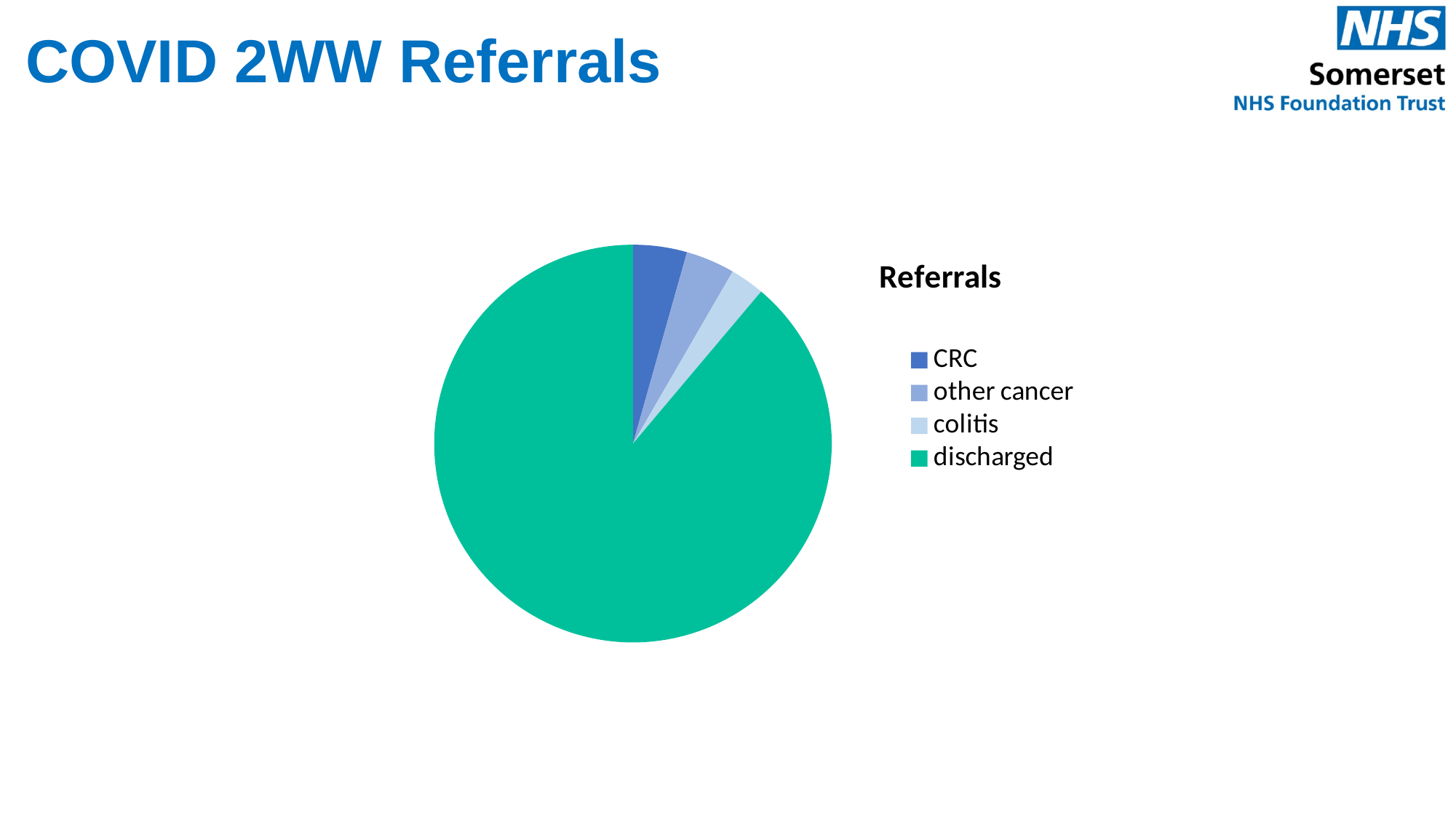
Which category is listed first in the legend? CRC Does the discharged slice account for more or less than half of the pie? more What is the title of the chart? Referrals Which legend entry is shown in green? discharged Which is larger, the slice for colitis or the slice for discharged? discharged What kind of chart is shown on the slide? pie chart Which is larger, the slice for discharged or the slice for CRC? discharged How many categories does the pie chart's legend list? 4 Which category has the largest slice of the pie? discharged